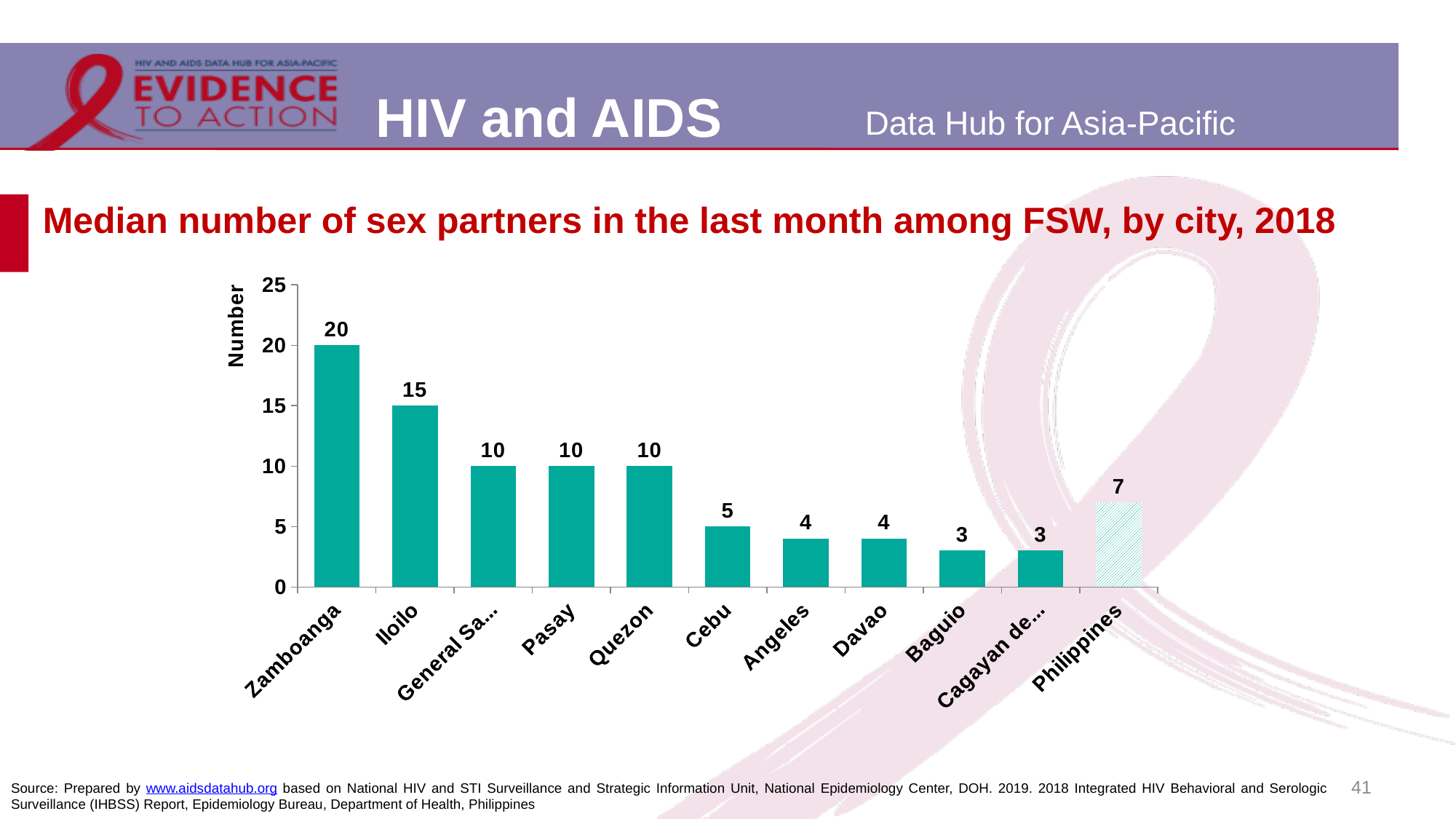
What is the label of the vertical axis? Number What is the value shown for the Philippines overall? 7 How many bars are shown in the chart? 11 What is the difference between the values for Pasay and Davao? 6 Which has a larger value, Baguio or the Philippines? Philippines Which city has the highest median number of sex partners? Zamboanga What type of chart is shown on the slide? Bar chart Which has a larger value, Cebu or Angeles? Cebu What is the value shown for Iloilo? 15 What is the difference between the values for Zamboanga and Iloilo? 5 What is the median number of sex partners in the last month among FSW in Zamboanga? 20 What is the value shown for Cebu? 5